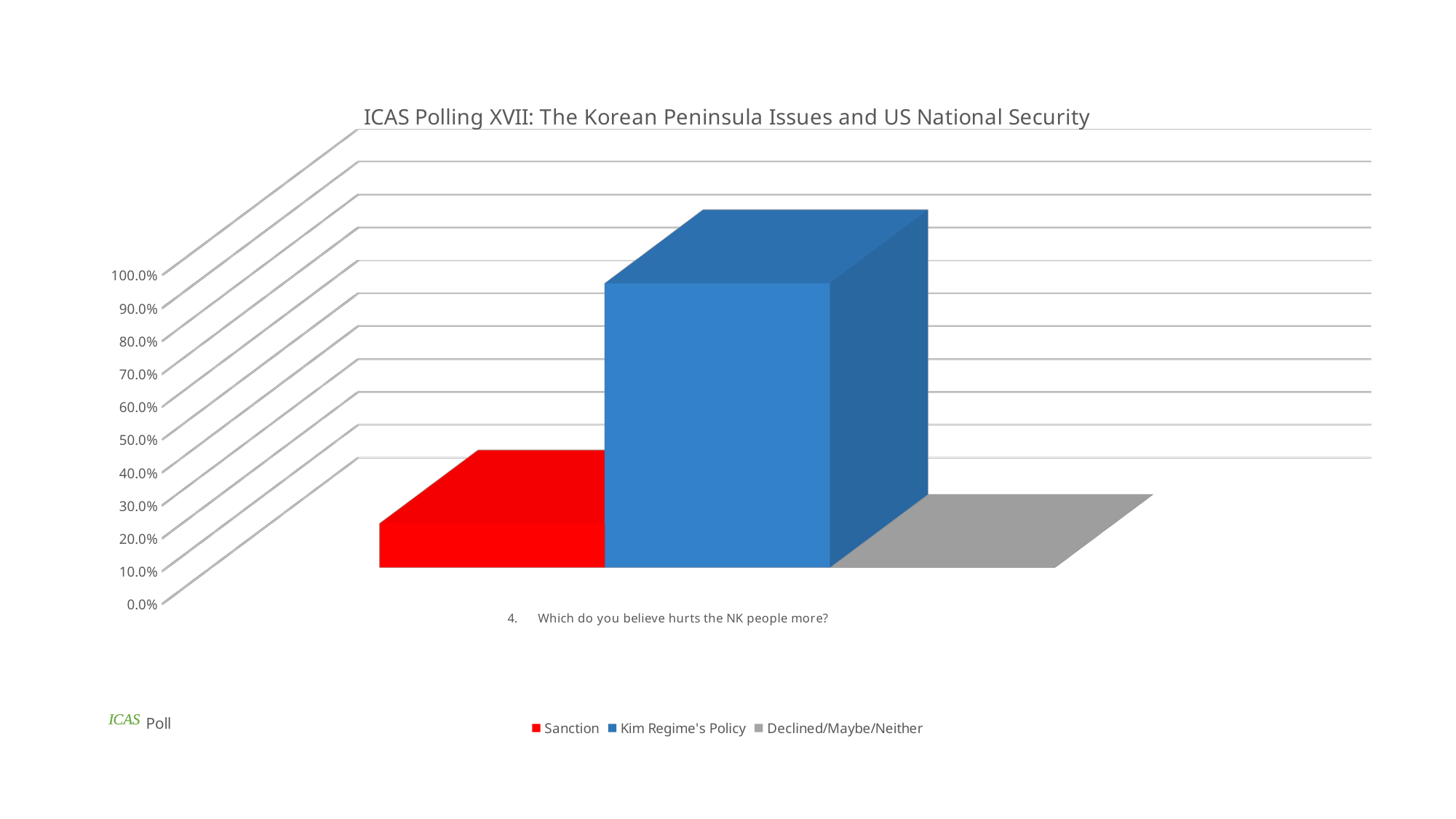
What kind of chart is shown on the slide? bar chart Is the value for Kim Regime's Policy greater or less than 70.0%? greater What is the title of the chart? ICAS Polling XVII: The Korean Peninsula Issues and US National Security How many categories are plotted on the x axis? 1 Is the value for Declined/Maybe/Neither greater or less than 10.0%? less Is the value for Sanction greater or less than 30.0%? less Which series has the highest value for the question "Which do you believe hurts the NK people more?"? Kim Regime's Policy How many series does the legend list? 3 Which series is shown in red in the legend? Sanction Which is larger, the value for Sanction or the value for Kim Regime's Policy? Kim Regime's Policy Which series has the lowest value for the question "Which do you believe hurts the NK people more?"? Declined/Maybe/Neither What is the question text shown as the category label on the x axis? Which do you believe hurts the NK people more?